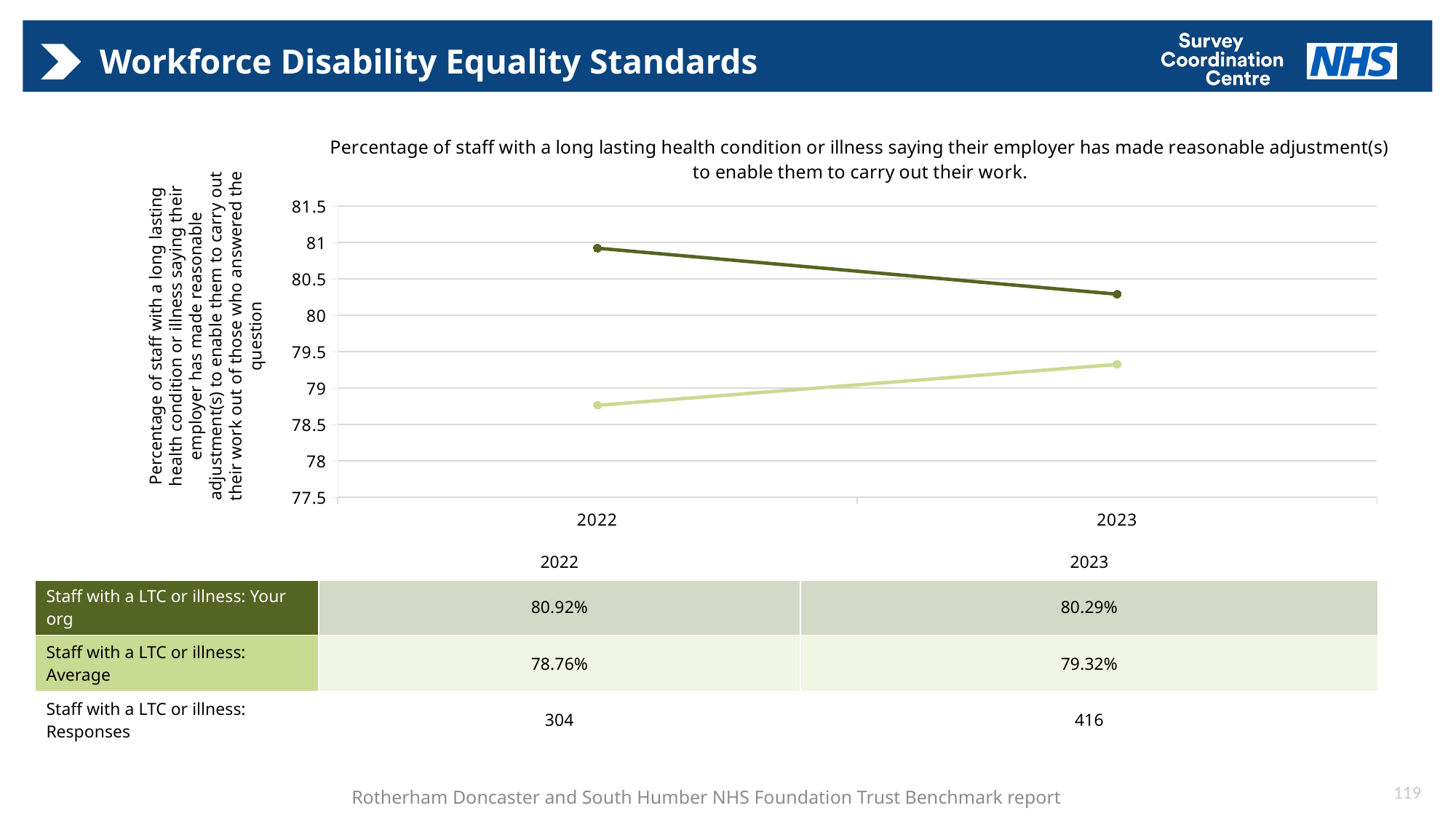
How many responses were there from staff with a LTC or illness in 2023? 416 Does the 'Average' line rise or fall from 2022 to 2023? rise Does the 'Your org' line rise or fall from 2022 to 2023? fall What type of chart is shown on the slide? line chart What is the value for 'Staff with a LTC or illness: Average' in 2023? 79.32% How many years are shown on the x axis? 2 In which year was the 'Your org' value highest? 2022 What is the value for 'Staff with a LTC or illness: Your org' in 2022? 80.92% What is the difference between 'Your org' and 'Average' in 2022? 2.16% Is the 'Average' value for 2022 greater or less than 79? less Which is larger in 2023: 'Your org' or 'Average'? Your org What is the value for 'Staff with a LTC or illness: Your org' in 2023? 80.29%